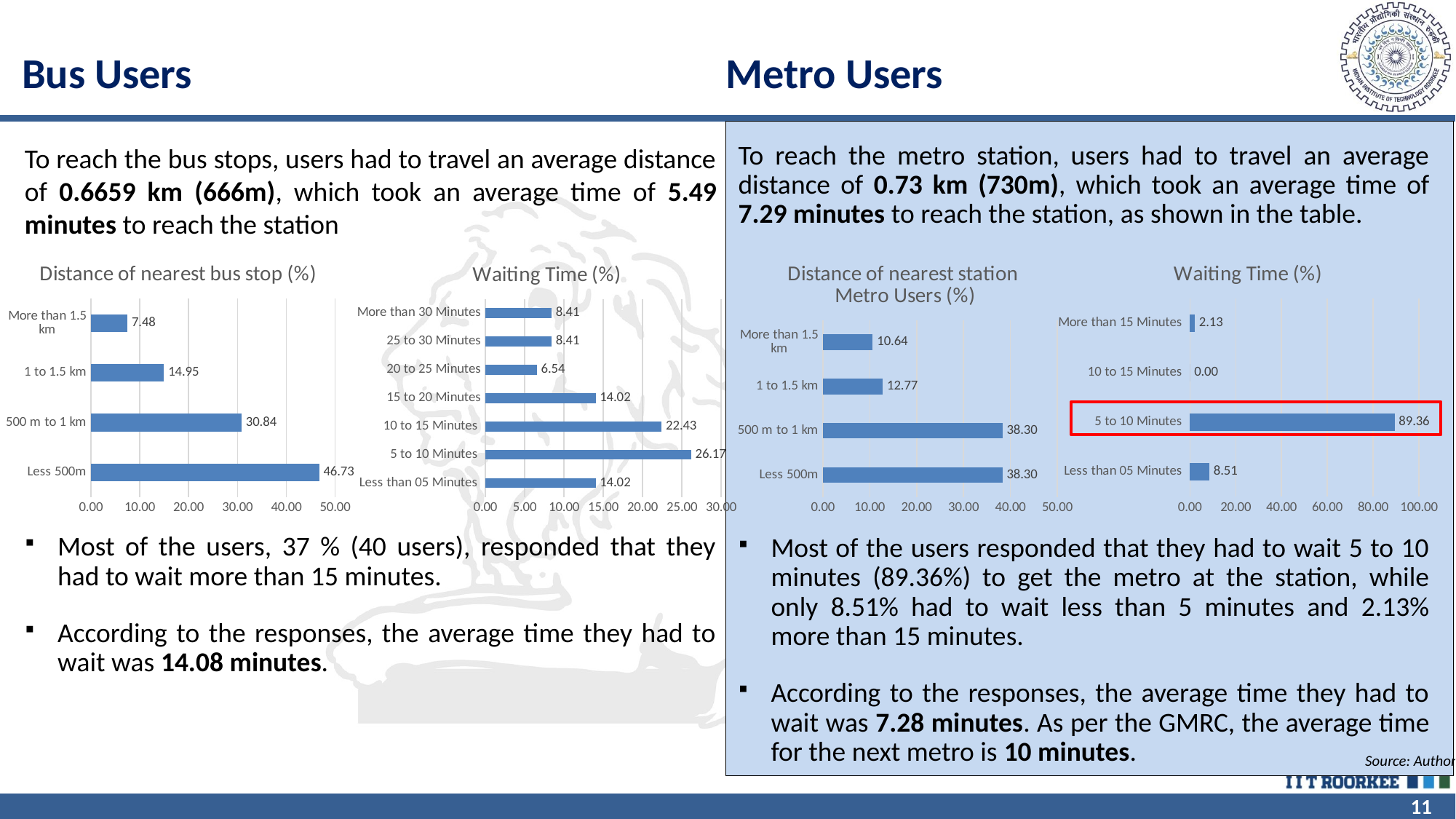
In the Bus Users 'Waiting Time (%)' chart (second chart from the left), which category has the lowest value? 20 to 25 Minutes In the 'Distance of nearest bus stop (%)' chart, which category has the lowest value? More than 1.5 km In the Metro Users 'Waiting Time (%)' chart (right-most chart), what is the value for '10 to 15 Minutes'? 0.00 In the 'Distance of nearest bus stop (%)' chart, what is the value for 'Less 500m'? 46.73 In the 'Distance of nearest station Metro Users (%)' chart, which is larger: 'More than 1.5 km' or '1 to 1.5 km'? 1 to 1.5 km In the 'Distance of nearest bus stop (%)' chart, what is the difference between '500 m to 1 km' and '1 to 1.5 km'? 15.89 What type of chart is the 'Distance of nearest station Metro Users (%)' chart? Bar chart How many categories are shown in the Bus Users 'Waiting Time (%)' chart (second chart from the left)? 7 In the Bus Users 'Waiting Time (%)' chart (second chart from the left), what is the value for '10 to 15 Minutes'? 22.43 In the 'Distance of nearest station Metro Users (%)' chart, what is the value for '1 to 1.5 km'? 12.77 In the Bus Users 'Waiting Time (%)' chart (second chart from the left), which category has the highest value? 5 to 10 Minutes In the Metro Users 'Waiting Time (%)' chart (right-most chart), what is the value for '5 to 10 Minutes'? 89.36